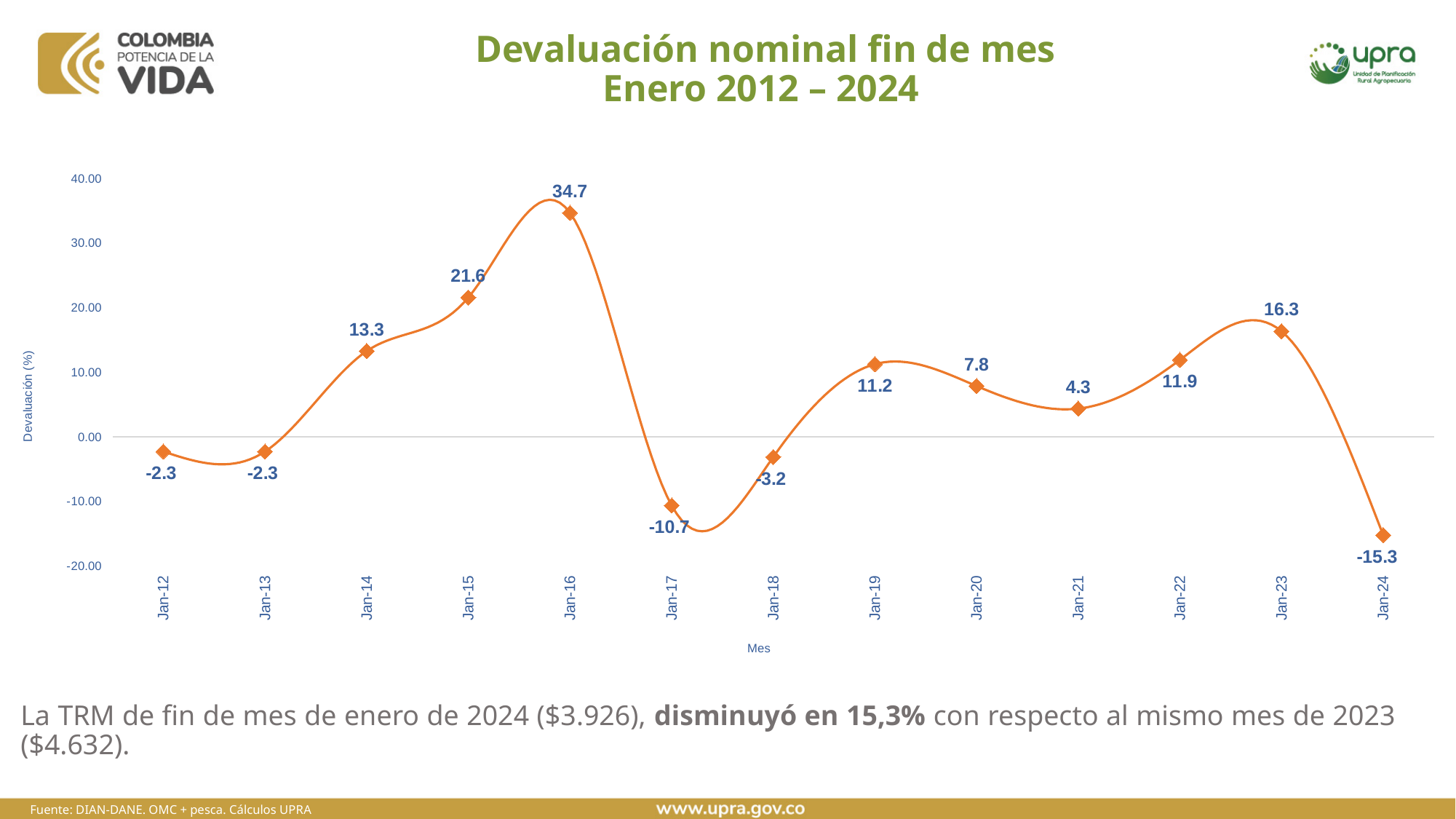
How many data points are plotted on the chart? 13 What is the difference between the values for Jan-23 and Jan-24? 31.6 Which month has the lowest devaluation value? Jan-24 What is the difference between the values for Jan-15 and Jan-14? 8.3 What is the devaluation value for Jan-19? 11.2 Is the value for Jan-17 greater or less than 0.00? less Which month has the highest devaluation value? Jan-16 What is the devaluation value for Jan-24? -15.3 What kind of chart is shown on the slide? line chart What is the label of the y axis? Devaluación (%) Which is larger, the value for Jan-20 or the value for Jan-21? Jan-20 What is the devaluation value for Jan-16? 34.7